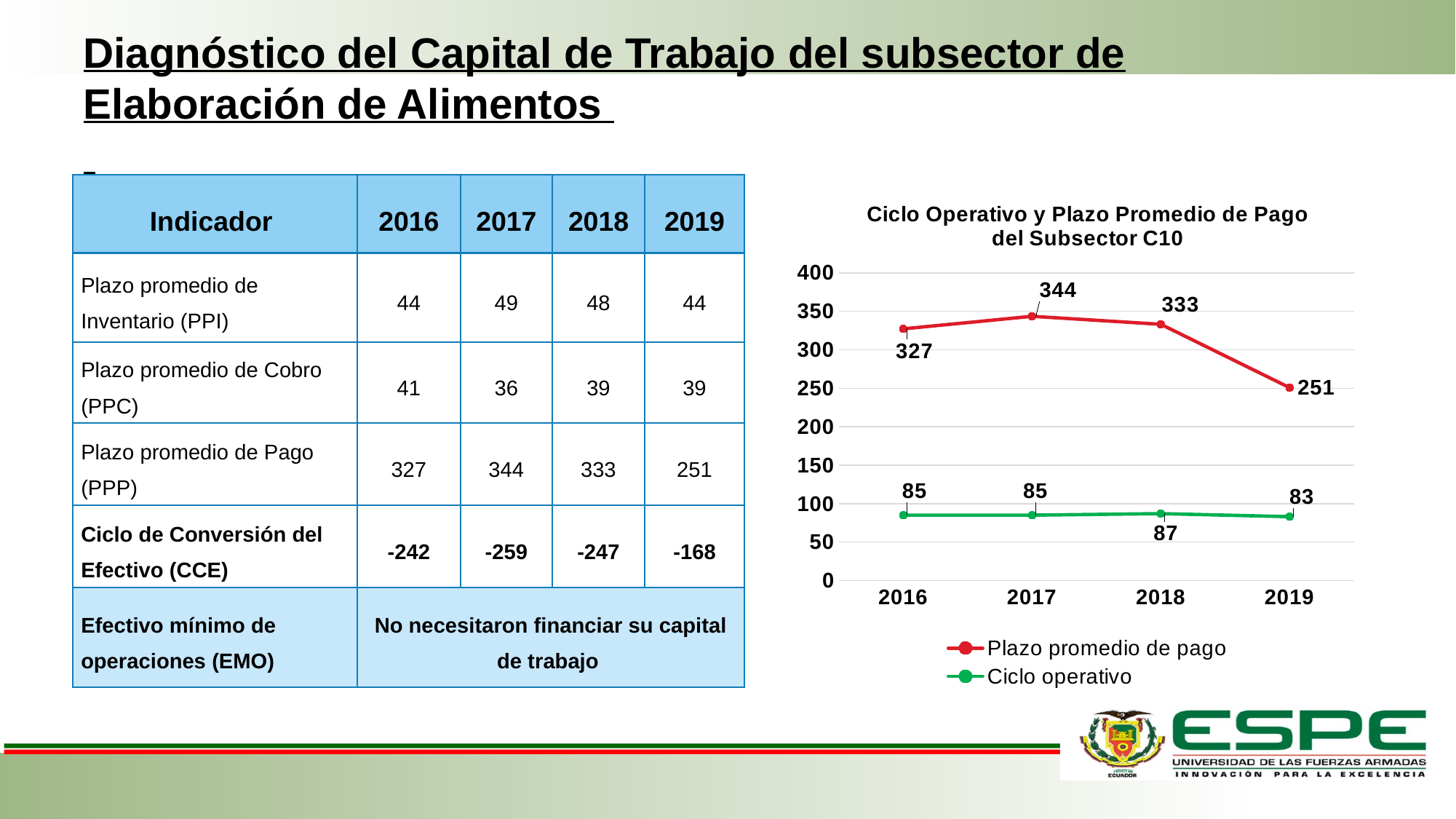
What is the title of the chart? Ciclo Operativo y Plazo Promedio de Pago del Subsector C10 In which year is Plazo promedio de pago highest? 2017 What is the value of Plazo promedio de pago in 2017? 344 How many series does the legend list? 2 What is the value of Plazo promedio de pago in 2019? 251 What type of chart is shown on the slide? Line chart In which year is Plazo promedio de pago lowest? 2019 Which is larger, Ciclo operativo in 2018 or Ciclo operativo in 2019? 2018 What is the value of Ciclo operativo in 2018? 87 How many years are plotted on the x axis? 4 What is the difference between Plazo promedio de pago in 2018 and 2019? 82 Is the value of Plazo promedio de pago in 2016 greater or less than 300? greater